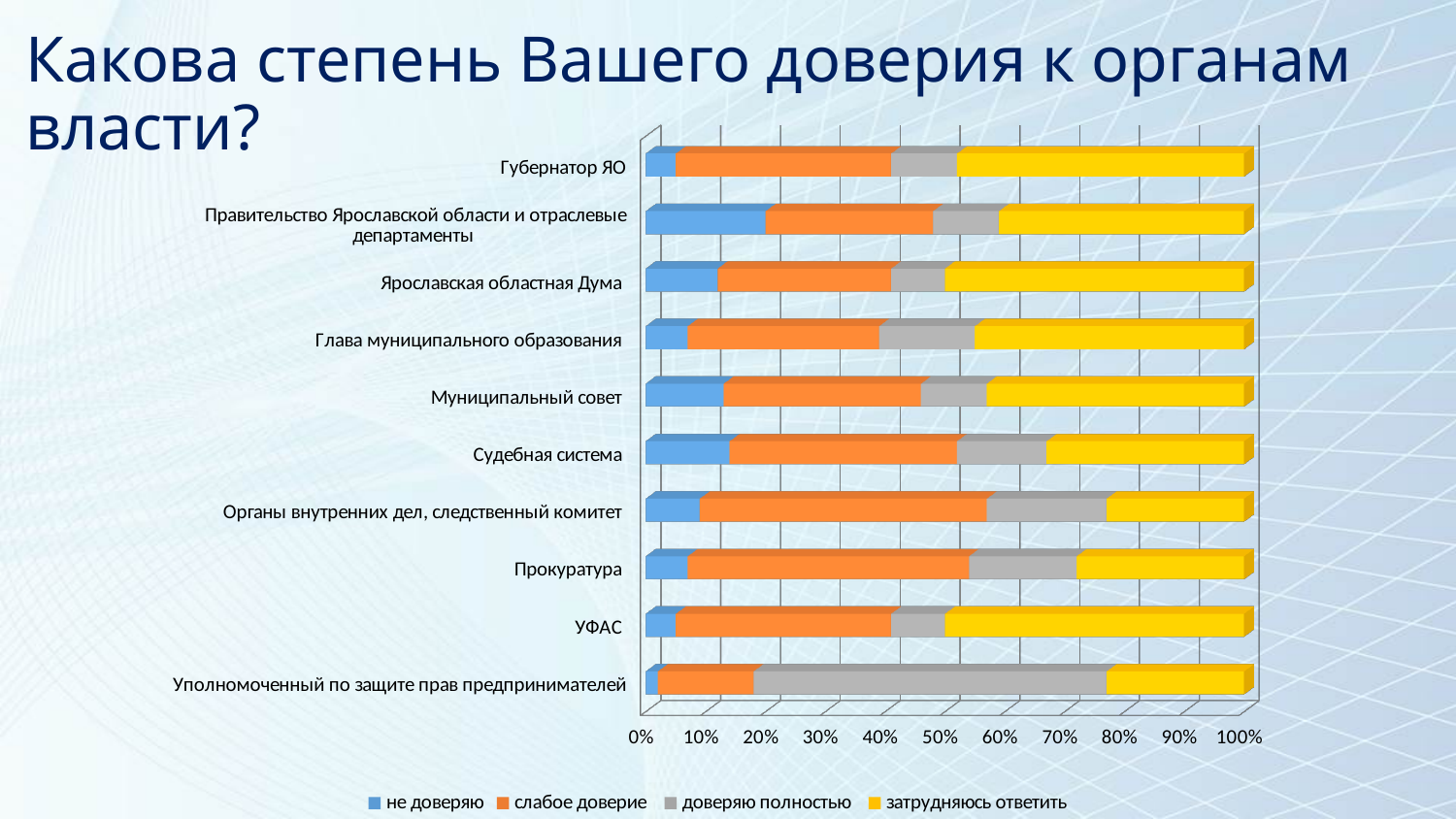
Which colour represents the series "затрудняюсь ответить" in the legend? Yellow Which has a larger "доверяю полностью" segment: УФАС or Уполномоченный по защите прав предпринимателей? Уполномоченный по защите прав предпринимателей What kind of chart is shown on the slide? Stacked bar chart What is the title of the slide? Какова степень Вашего доверия к органам власти? How many categories (authorities) are listed on the chart? 10 Which has a larger "не доверяю" segment: Губернатор ЯО or Правительство Ярославской области и отраслевые департаменты? Правительство Ярославской области и отраслевые департаменты Which category has the largest "не доверяю" segment? Правительство Ярославской области и отраслевые департаменты Which category has the smallest "слабое доверие" segment? Уполномоченный по защите прав предпринимателей Which category has the largest "доверяю полностью" segment? Уполномоченный по защите прав предпринимателей Is the "не доверяю" share for Уполномоченный по защите прав предпринимателей greater or less than 10%? less Is the "не доверяю" share for Правительство Ярославской области и отраслевые департаменты greater or less than 10%? greater How many series does the legend list? 4